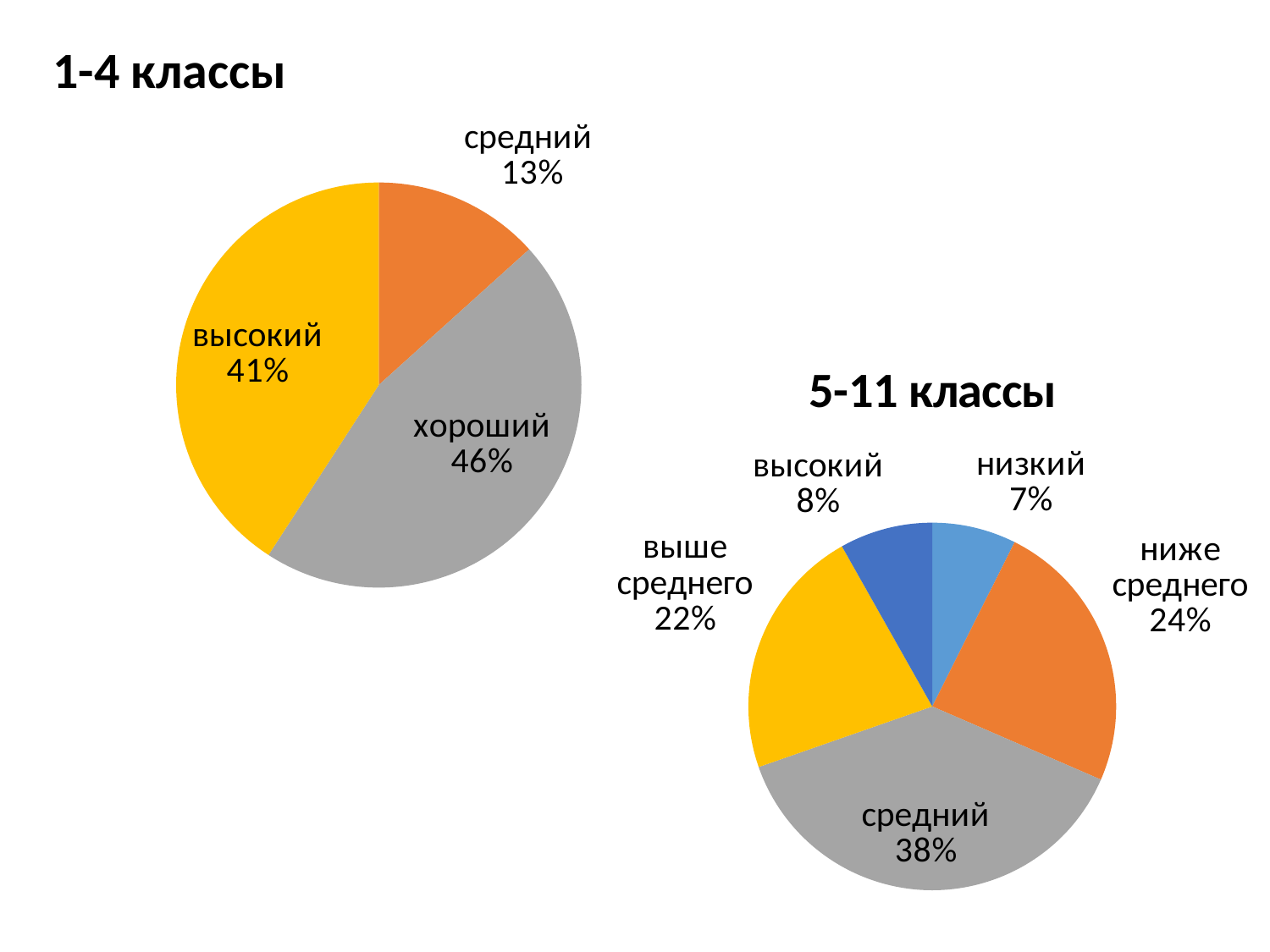
In the "1-4 классы" chart, how many slices are there? 3 In the "5-11 классы" chart, what share does "ниже среднего" have? 24% In the "5-11 классы" chart, which category has the smallest share? низкий In the "1-4 классы" chart, what share does "средний" have? 13% In the "5-11 классы" chart, what share does "выше среднего" have? 22% In the "1-4 классы" chart, what share does "хороший" have? 46% In the "5-11 классы" chart, how many categories are shown? 5 In the "1-4 классы" chart, what is the difference between the shares of "хороший" and "высокий"? 5% In the "1-4 классы" chart, which category has the largest share? хороший In the "1-4 классы" chart, which category has the smallest share? средний What type of chart is the "5-11 классы" chart? pie chart In the "5-11 классы" chart, which category has the largest share? средний